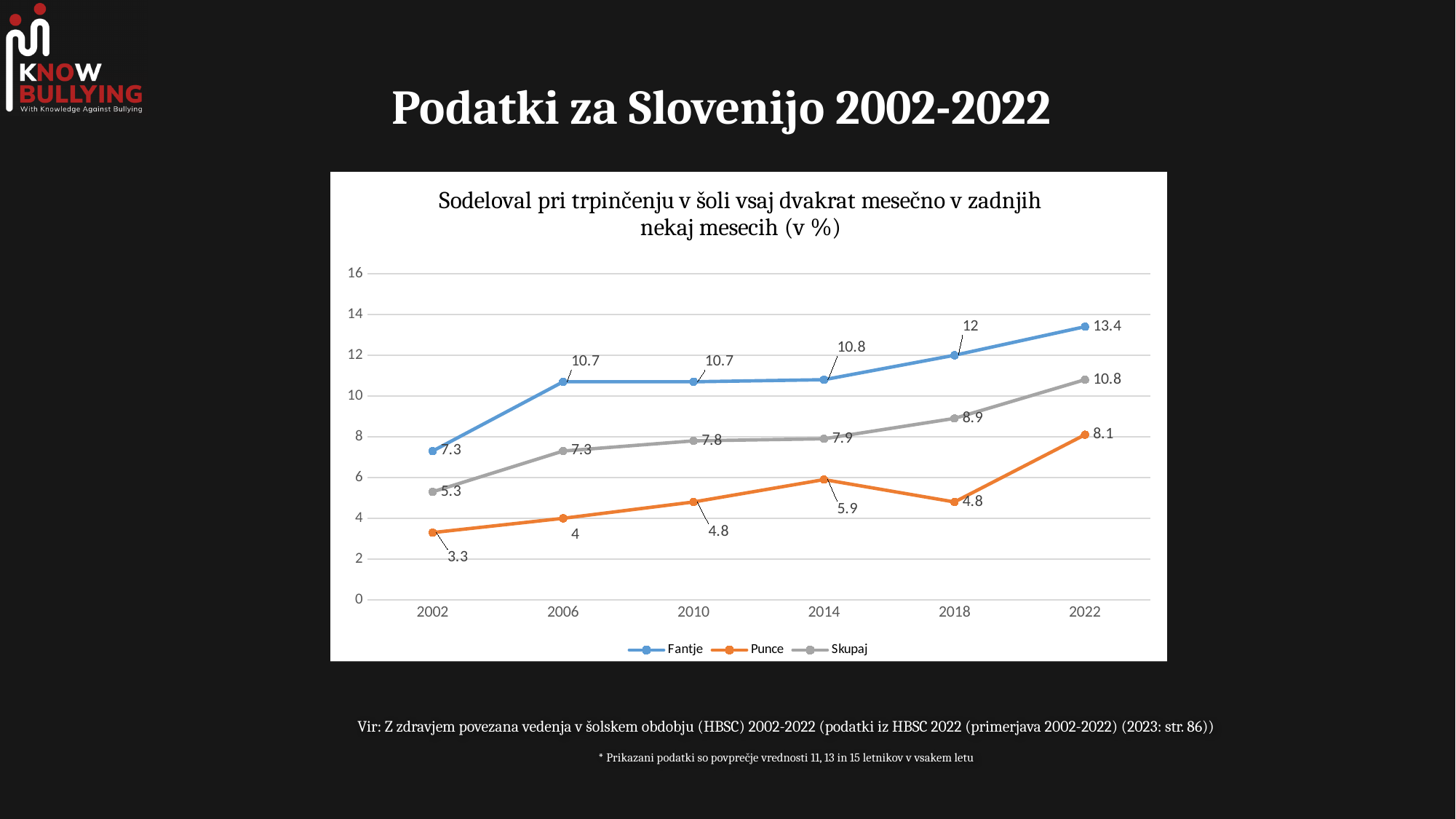
What is the value for Punce in 2014? 5.9 What kind of chart is shown on the slide? Line chart Which series is drawn in orange? Punce Does the Skupaj series rise or fall from 2002 to 2022? Rise In which year is the Punce series lowest? 2002 What is the value for Skupaj in 2002? 5.3 In which year is the Fantje series highest? 2022 Which is larger in 2018: the Skupaj value or the Punce value? Skupaj How many years are shown on the x axis? 6 How many series does the legend list? 3 What is the value for Fantje in 2022? 13.4 What is the difference between the Fantje and Punce values in 2022? 5.3